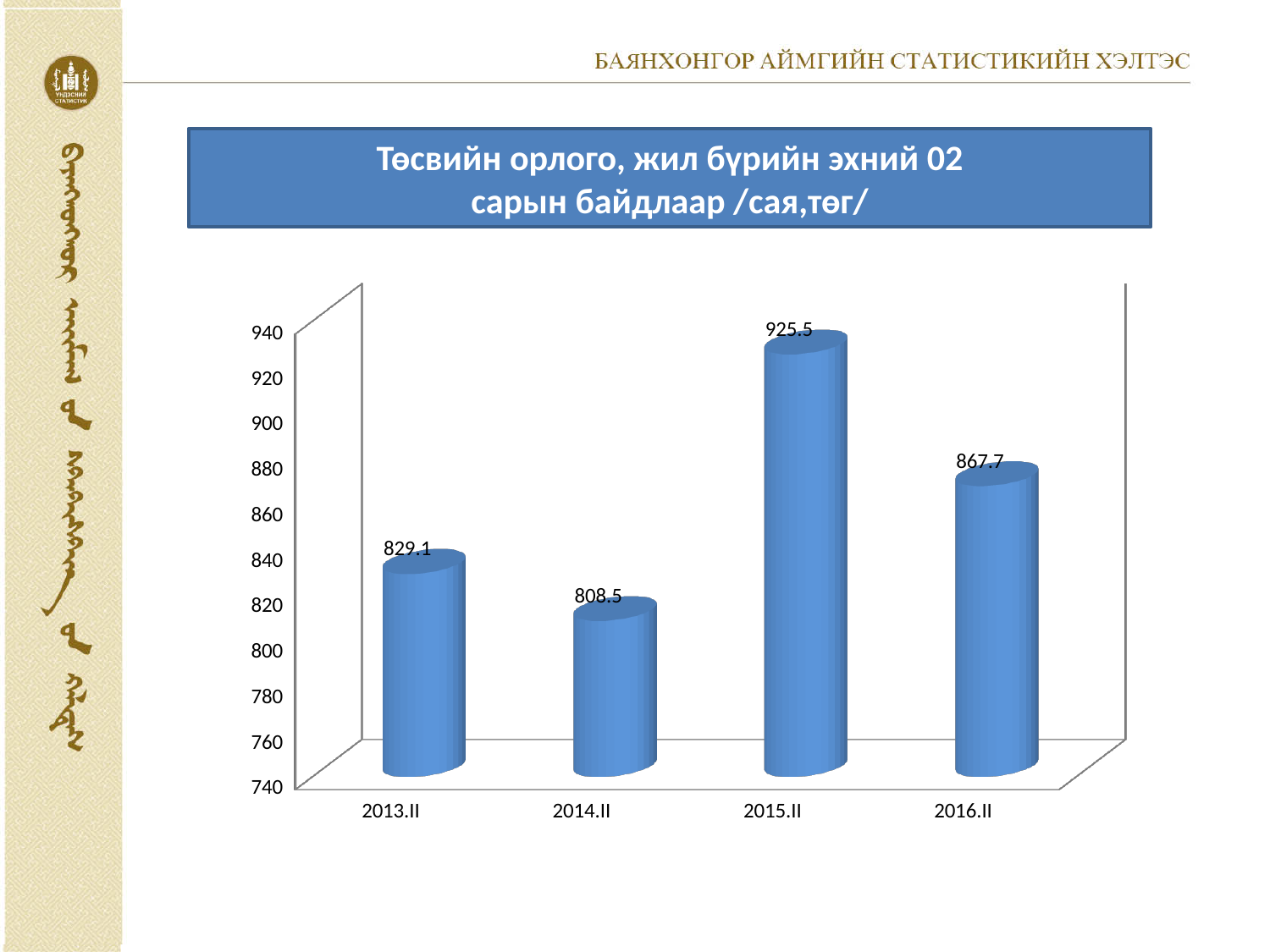
Does the value rise or fall from 2015.II to 2016.II? fall What kind of chart is shown on the slide? bar chart Which category has the highest value? 2015.II What is the difference between the values for 2016.II and 2013.II? 38.6 What is the value for 2013.II? 829.1 What is the value for 2016.II? 867.7 What is the difference between the values for 2015.II and 2014.II? 117.0 Which is larger, the value for 2013.II or the value for 2016.II? 2016.II What is the value for 2014.II? 808.5 Which category has the lowest value? 2014.II What is the value for 2015.II? 925.5 How many categories are shown on the x axis? 4